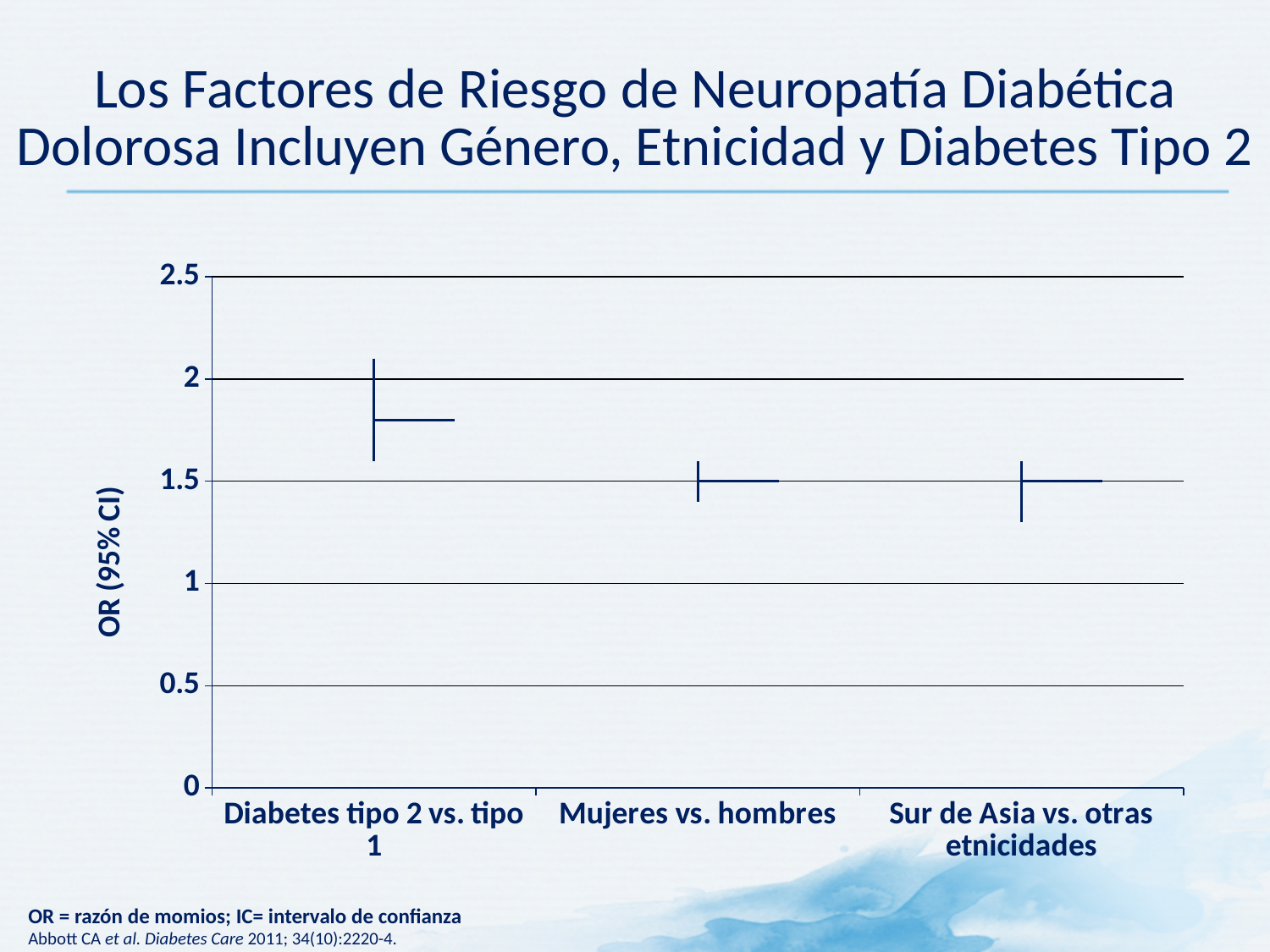
Which is larger, the OR for Diabetes tipo 2 vs. tipo 1 or the OR for Sur de Asia vs. otras etnicidades? Diabetes tipo 2 vs. tipo 1 Is the OR value for Sur de Asia vs. otras etnicidades greater or less than 2? less Which category has the highest OR value? Diabetes tipo 2 vs. tipo 1 What is the maximum value shown on the vertical axis of the chart? 2.5 How many categories are shown on the x axis of the chart? 3 Is the OR value for Diabetes tipo 2 vs. tipo 1 greater or less than 1.5? greater Is the OR value for Diabetes tipo 2 vs. tipo 1 greater or less than 2? less Which is larger, the OR for Diabetes tipo 2 vs. tipo 1 or the OR for Mujeres vs. hombres? Diabetes tipo 2 vs. tipo 1 What is the label of the vertical axis of the chart? OR (95% CI)